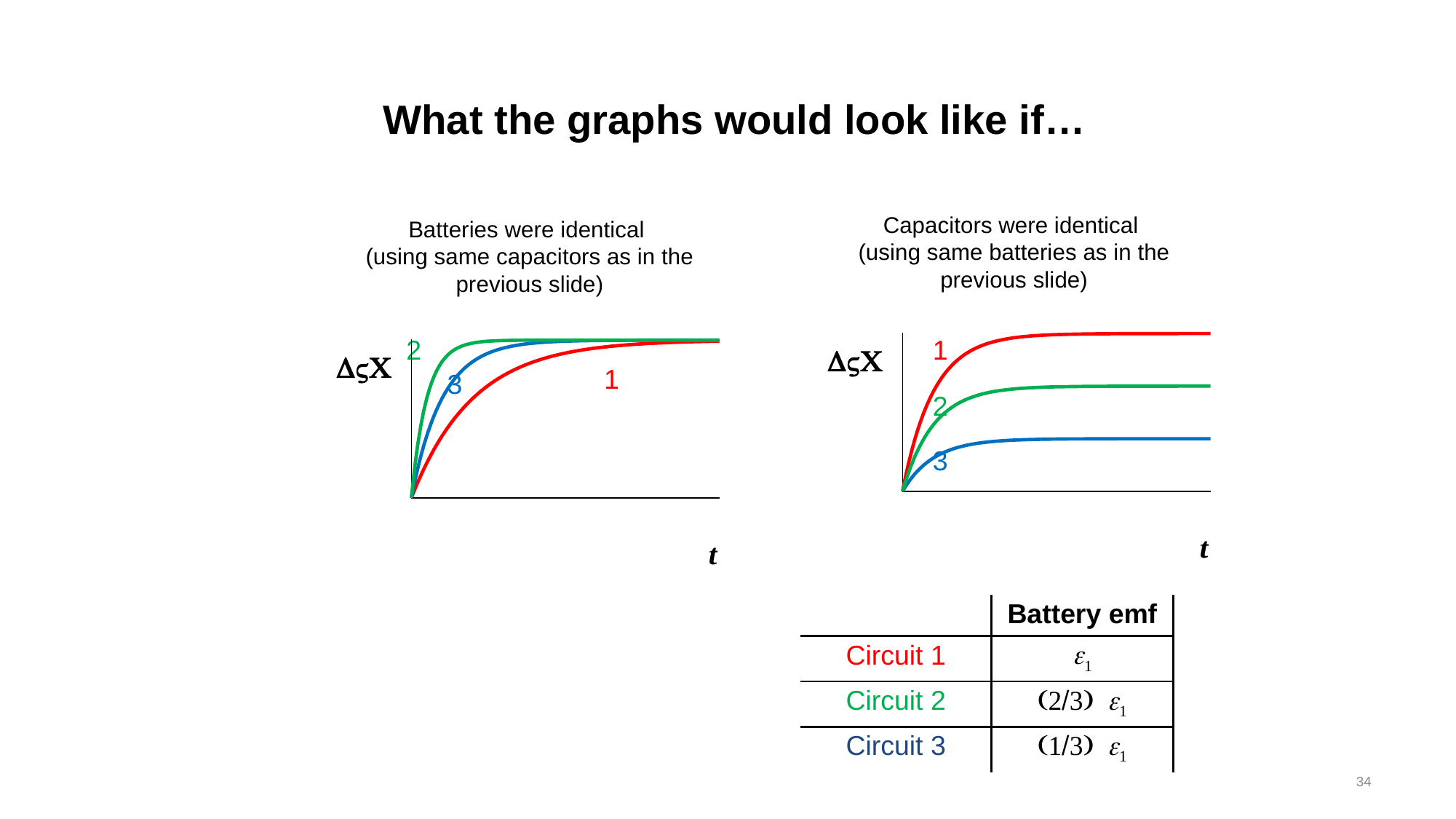
What kind of chart is the right chart titled "Capacitors were identical"? line chart On the right chart ("Capacitors were identical"), which curve levels off at the highest value? 1 On the right chart ("Capacitors were identical"), which curve reaches a higher final value, curve 2 or curve 3? curve 2 What kind of chart is the left chart titled "Batteries were identical"? line chart On the right chart ("Capacitors were identical"), what colour is curve 1? red On the right chart ("Capacitors were identical"), which curve levels off at the lowest value? 3 On the left chart ("Batteries were identical"), which curve rises to its plateau fastest? 2 On the left chart ("Batteries were identical"), which curve rises to its plateau slowest? 1 How many curves are plotted on the left chart ("Batteries were identical")? 3 How many curves are plotted on the right chart ("Capacitors were identical")? 3 What is the label on the horizontal axis of the right chart ("Capacitors were identical")? t On the left chart ("Batteries were identical"), do the curves rise or fall as t increases? rise